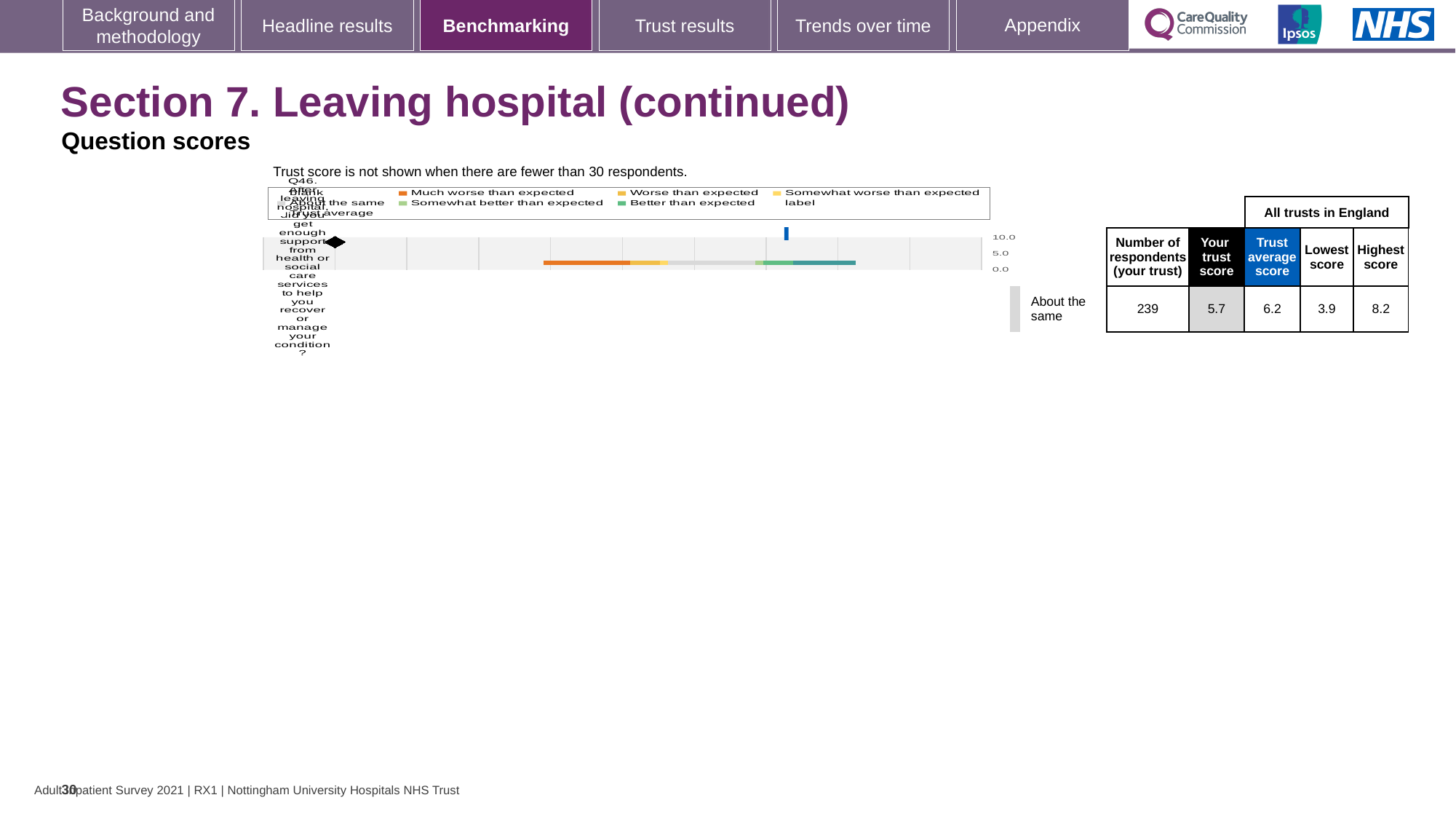
What is the highest value shown on the chart's score axis? 10.0 Which benchmark category is the trust's Q46 result placed in? About the same What is the trust average score for Q46 across all trusts in England? 6.2 How many respondents from the trust answered Q46? 239 What kind of chart is shown on the slide for Q46? Bar chart Which is larger for Q46: the trust's score or the trust average score? Trust average score What is the lowest score among all trusts in England for Q46? 3.9 What is the highest score among all trusts in England for Q46? 8.2 What is the trust's score for Q46 (support from health or social care services after leaving hospital)? 5.7 Is the trust's score for Q46 greater or less than 5.0? greater What is the difference between the highest score and the lowest score for Q46? 4.3 By how much does the trust average score exceed the trust's own score for Q46? 0.5